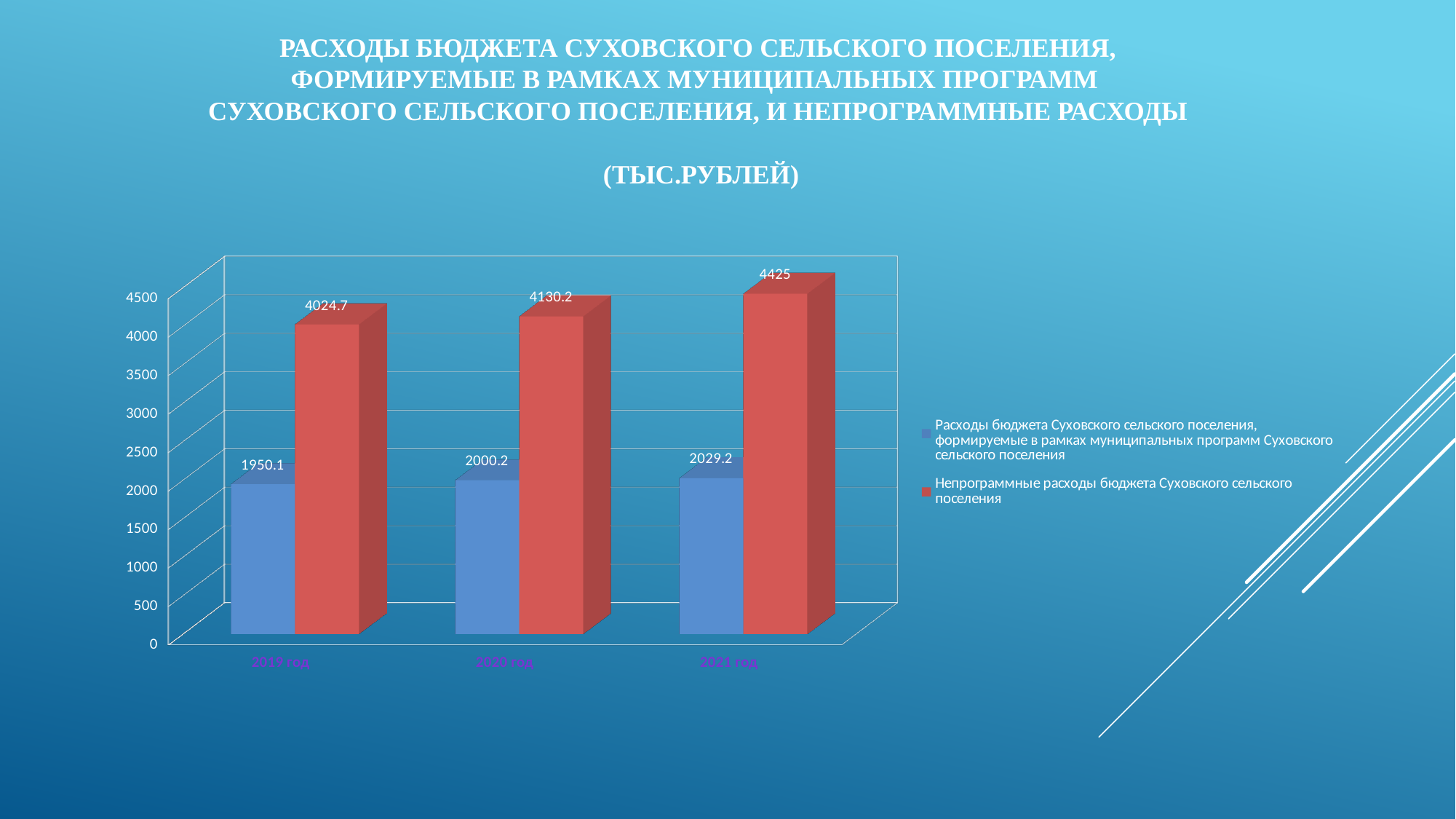
What kind of chart is shown on the slide? Bar chart What is the value of the non-program expenses bar for 2020 год? 4130.2 In which year is the non-program expenses value the highest? 2021 год Do the program expenses values rise or fall from 2019 год to 2021 год? Rise In which year is the program expenses value the lowest? 2019 год How many series does the legend list? 2 How many years are shown on the x axis? 3 What is the value of the program expenses (Расходы бюджета, формируемые в рамках муниципальных программ) bar for 2019 год? 1950.1 What is the difference between the non-program expenses in 2021 год and 2020 год? 294.8 What is the value of the non-program expenses (Непрограммные расходы) bar for 2021 год? 4425 Which is larger in 2020 год: program expenses or non-program expenses? Non-program expenses (4130.2) What is the value of the program expenses bar for 2021 год? 2029.2